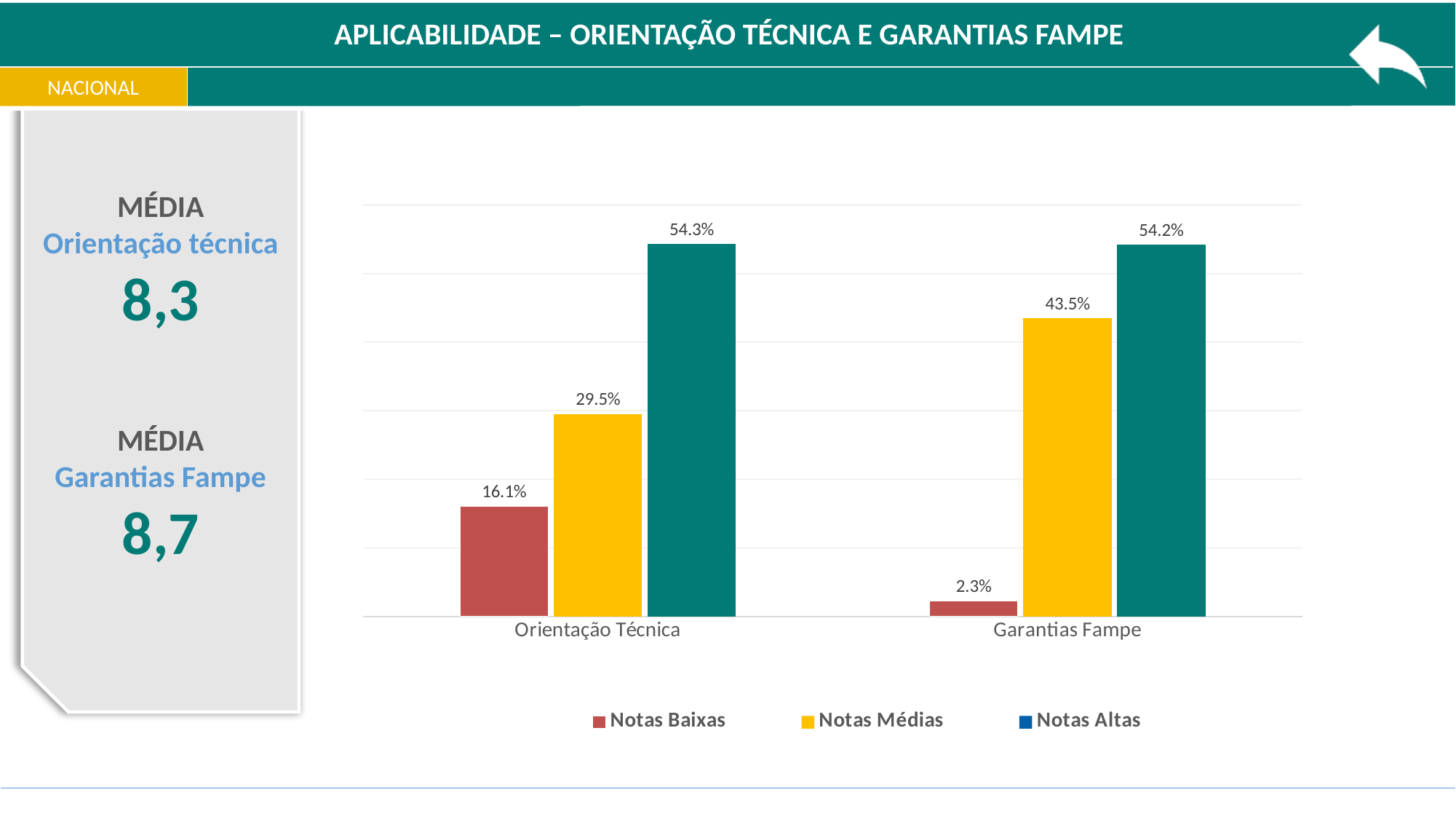
What is the value for Notas Altas in the Orientação Técnica category? 54.3% Which is larger: Notas Baixas for Orientação Técnica or Notas Baixas for Garantias Fampe? Orientação Técnica What is the difference between Notas Médias for Garantias Fampe and Notas Médias for Orientação Técnica? 14.0% How many categories are shown on the x axis of the chart? 2 Which series has the lowest value in the Orientação Técnica category? Notas Baixas How many series does the legend list? 3 What is the difference between Notas Baixas for Orientação Técnica and Notas Baixas for Garantias Fampe? 13.8% What is the value for Notas Médias in the Orientação Técnica category? 29.5% What is the value for Notas Médias in the Garantias Fampe category? 43.5% What kind of chart is shown on the slide? Bar chart What is the value for Notas Baixas in the Garantias Fampe category? 2.3% Which series has the highest value in the Garantias Fampe category? Notas Altas